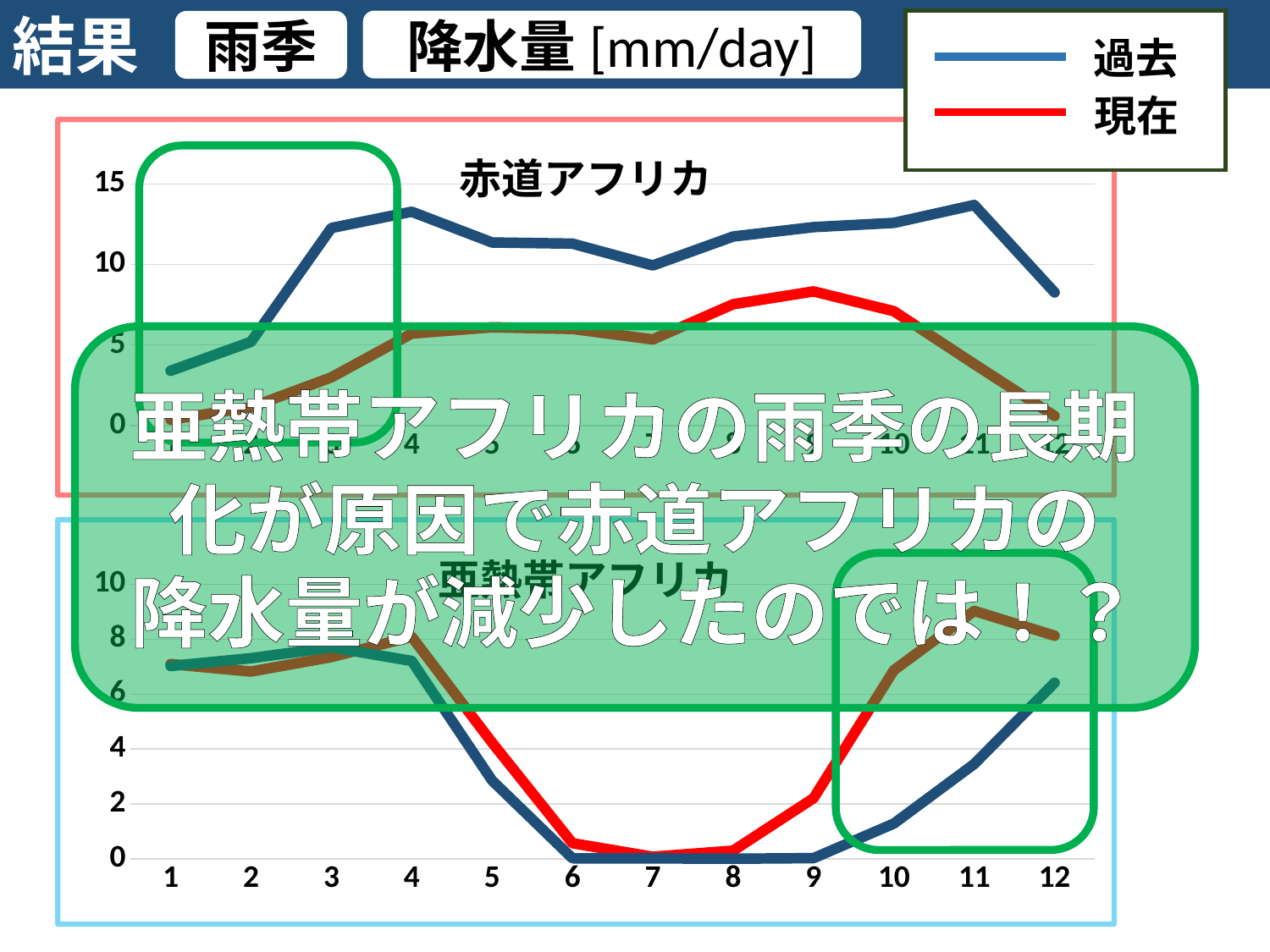
In the top chart 赤道アフリカ, which series has the larger value at month 11, 過去 or 現在? 過去 How many series does the legend list? 2 Which colour represents the 現在 series in the legend? red In the top chart 赤道アフリカ, is the 過去 value at month 11 greater or less than 10? greater In the bottom chart 亜熱帯アフリカ, which series has the larger value at month 5, 過去 or 現在? 現在 In the bottom chart 亜熱帯アフリカ, is the 現在 value at month 12 greater or less than 6? greater In the top chart 赤道アフリカ, is the 過去 value at month 1 greater or less than 5? less What kind of chart is the top chart titled 赤道アフリカ? line chart What unit is shown for 降水量 in the slide header? mm/day How many points along the x axis does the bottom chart 亜熱帯アフリカ have? 12